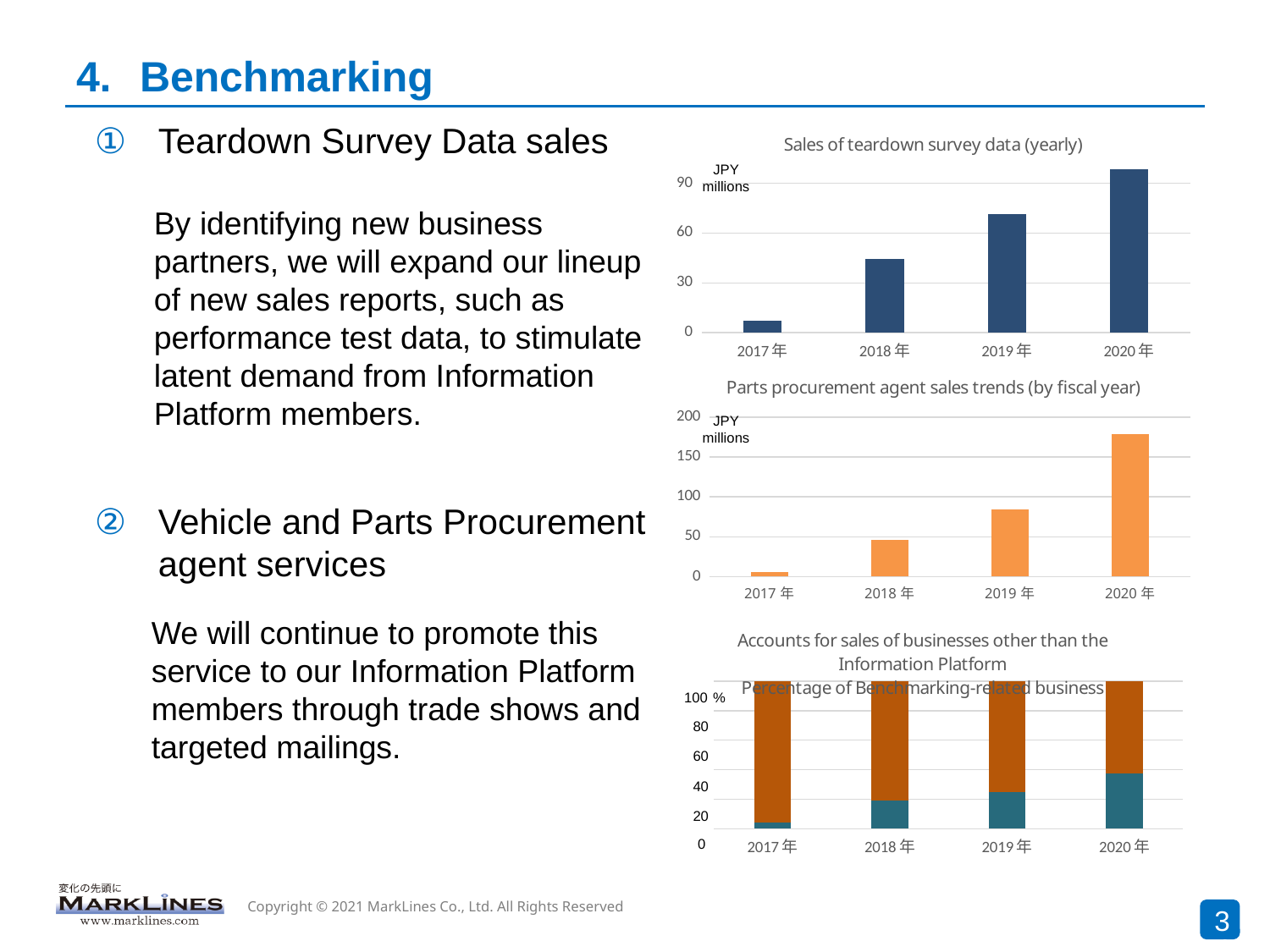
How many years are shown in the "Parts procurement agent sales trends (by fiscal year)" chart? 4 In the "Sales of teardown survey data (yearly)" chart, which year has the highest value? 2020年 In the "Sales of teardown survey data (yearly)" chart, do the values rise or fall from 2017年 to 2020年? rise What unit is shown on the y axis of the "Sales of teardown survey data (yearly)" chart? JPY millions In the "Parts procurement agent sales trends (by fiscal year)" chart, which is larger, the value for 2018 年 or 2019 年? 2019 年 In the "Sales of teardown survey data (yearly)" chart, which year has the lowest value? 2017年 In the "Parts procurement agent sales trends (by fiscal year)" chart, is the value for 2020 年 greater or less than 150? greater In the "Sales of teardown survey data (yearly)" chart, is the value for 2018年 greater or less than 30? greater What type of chart is "Sales of teardown survey data (yearly)"? bar chart In the "Parts procurement agent sales trends (by fiscal year)" chart, is the value for 2019 年 greater or less than 100? less In the "Parts procurement agent sales trends (by fiscal year)" chart, which year has the highest value? 2020 年